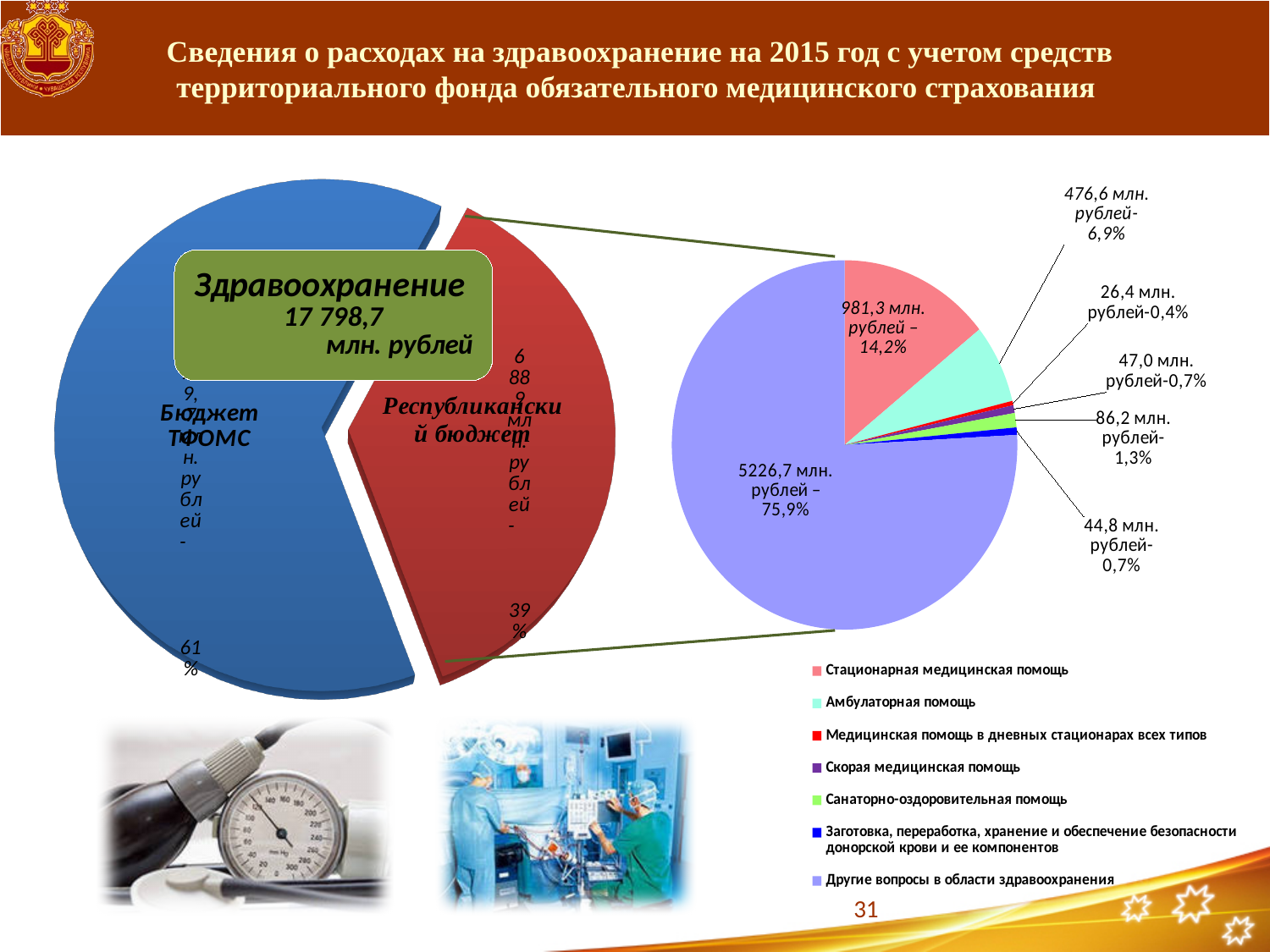
On the left pie chart, what share is labelled for Бюджет ТФОМС? 61% On the left pie chart, how many slices are there? 2 On the left pie chart, which of the two slices is larger, Бюджет ТФОМС or Республиканский бюджет? Бюджет ТФОМС What total amount for Здравоохранение is shown in the box over the left pie chart? 17 798,7 млн. рублей On the right pie chart, which category has the largest share? Другие вопросы в области здравоохранения On the right pie chart, what percentage is labelled for Амбулаторная помощь? 6,9% On the right pie chart, what percentage is labelled for Другие вопросы в области здравоохранения? 75,9% On the right pie chart, how many categories does the legend list? 7 On the right pie chart, what amount is labelled for Стационарная медицинская помощь? 981,3 млн. рублей What type of chart is the chart on the right side of the slide? Pie chart On the right pie chart, which category has the smallest share? Медицинская помощь в дневных стационарах всех типов On the left pie chart, what share is labelled for Республиканский бюджет? 39%